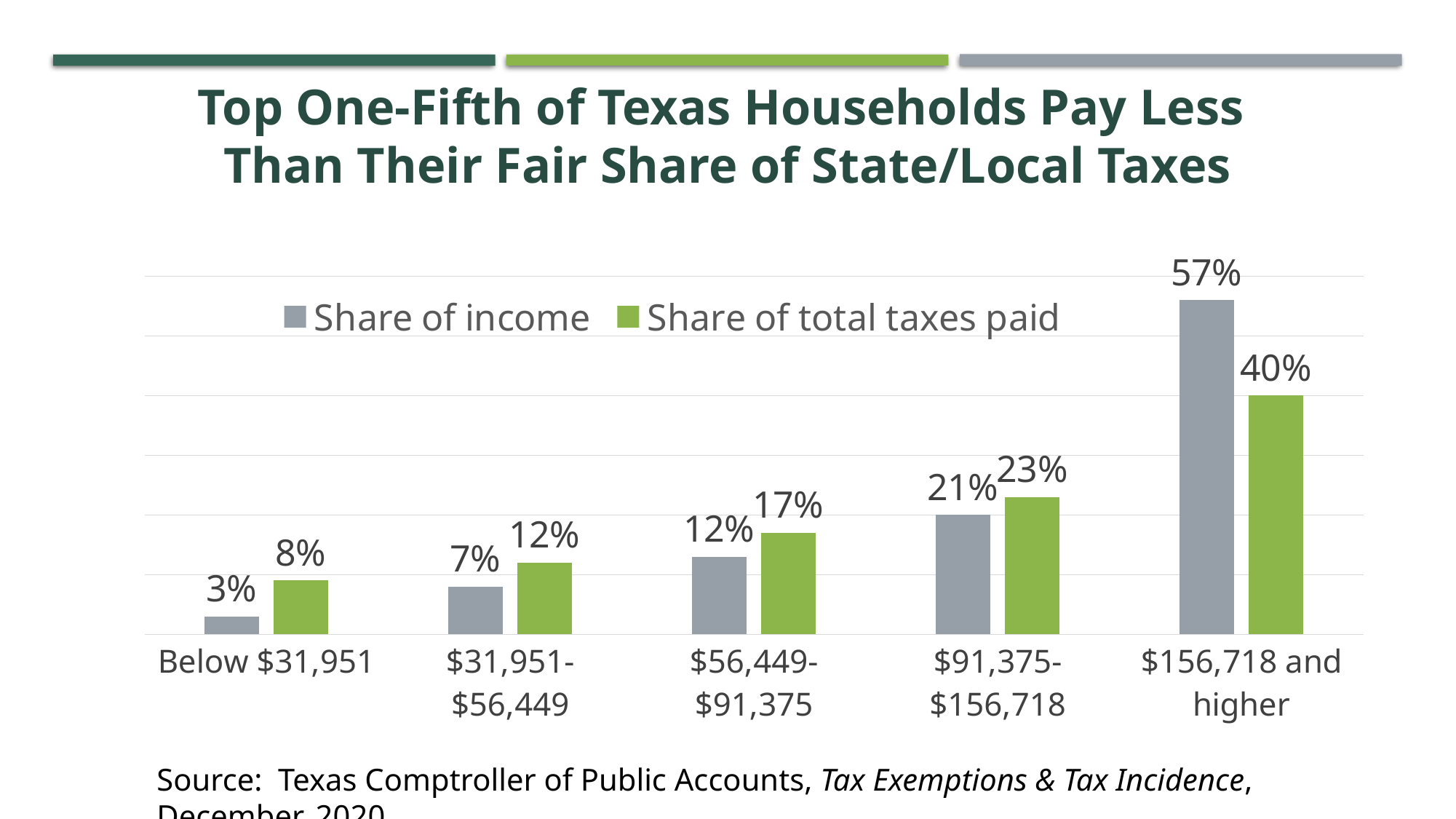
What is the share of income for the $56,449-$91,375 income group? 12% Which income group has the lowest share of income? Below $31,951 Which colour represents the 'Share of total taxes paid' series? Green Which income group has the highest share of total taxes paid? $156,718 and higher What is the difference between the share of income and the share of total taxes paid for the $156,718 and higher group? 17 percentage points What is the share of total taxes paid by households earning below $31,951? 8% For the $31,951-$56,449 group, which is larger: share of income or share of total taxes paid? Share of total taxes paid How many series does the legend list? 2 How many income groups are shown on the x axis? 5 What is the share of income for households earning $156,718 and higher? 57% Does the share of income rise or fall as income groups increase from left to right? Rise What kind of chart is shown on the slide? Bar chart